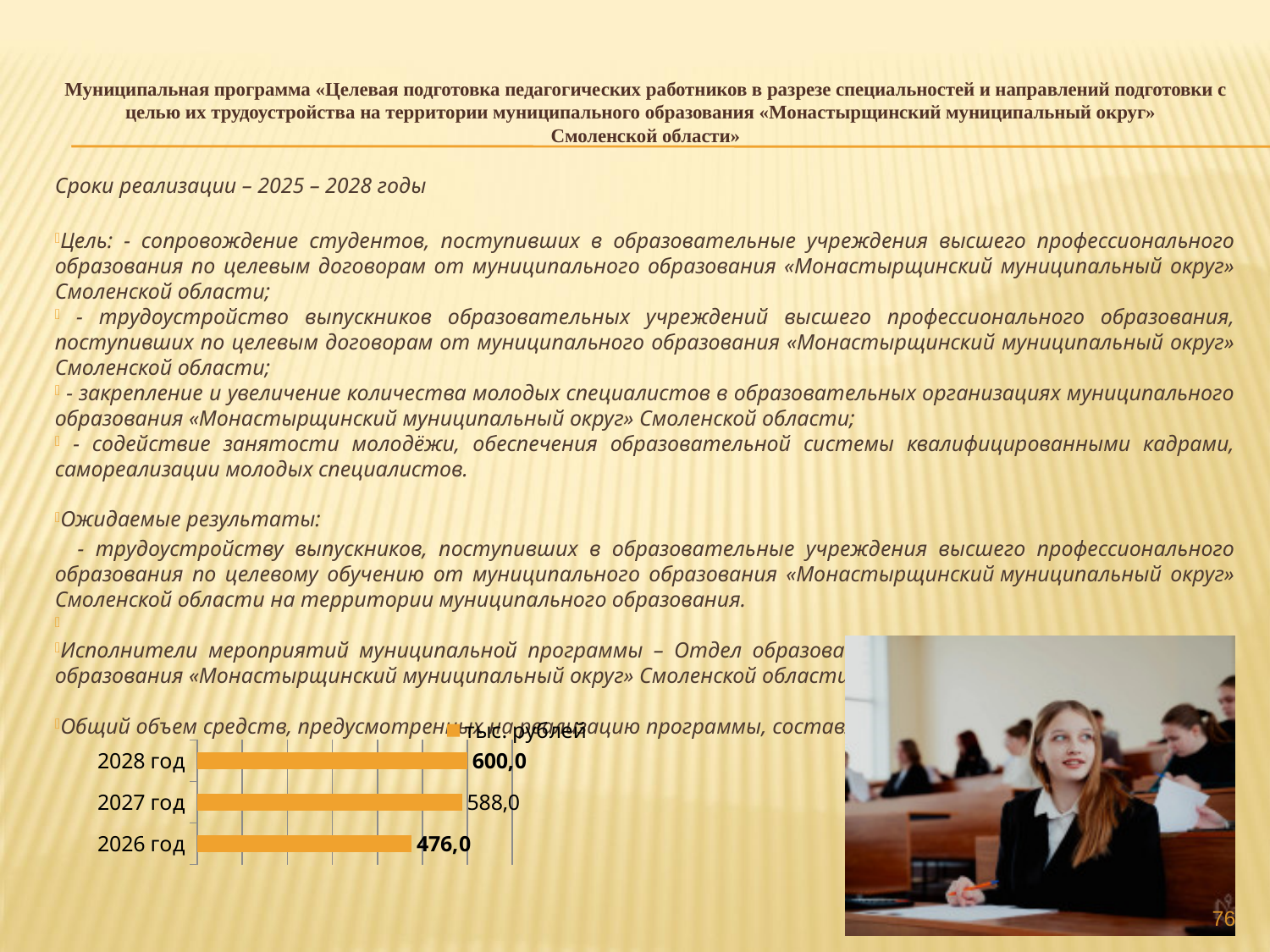
Which is larger, the value for 2027 год or the value for 2026 год? 2027 год What unit does the chart legend give for the values? тыс. рублей Which year has the highest value in the bar chart? 2028 год What kind of chart is shown on the slide? bar chart How many categories (years) are shown in the bar chart? 3 Which year has the lowest value in the bar chart? 2026 год What is the value for 2027 год in the bar chart? 588,0 What is the value for 2028 год in the bar chart? 600,0 What is the difference between the values for 2028 год and 2026 год? 124,0 What is the difference between the values for 2027 год and 2026 год? 112,0 What is the value for 2026 год in the bar chart? 476,0 Do the values in the chart rise or fall from 2026 год to 2028 год? rise